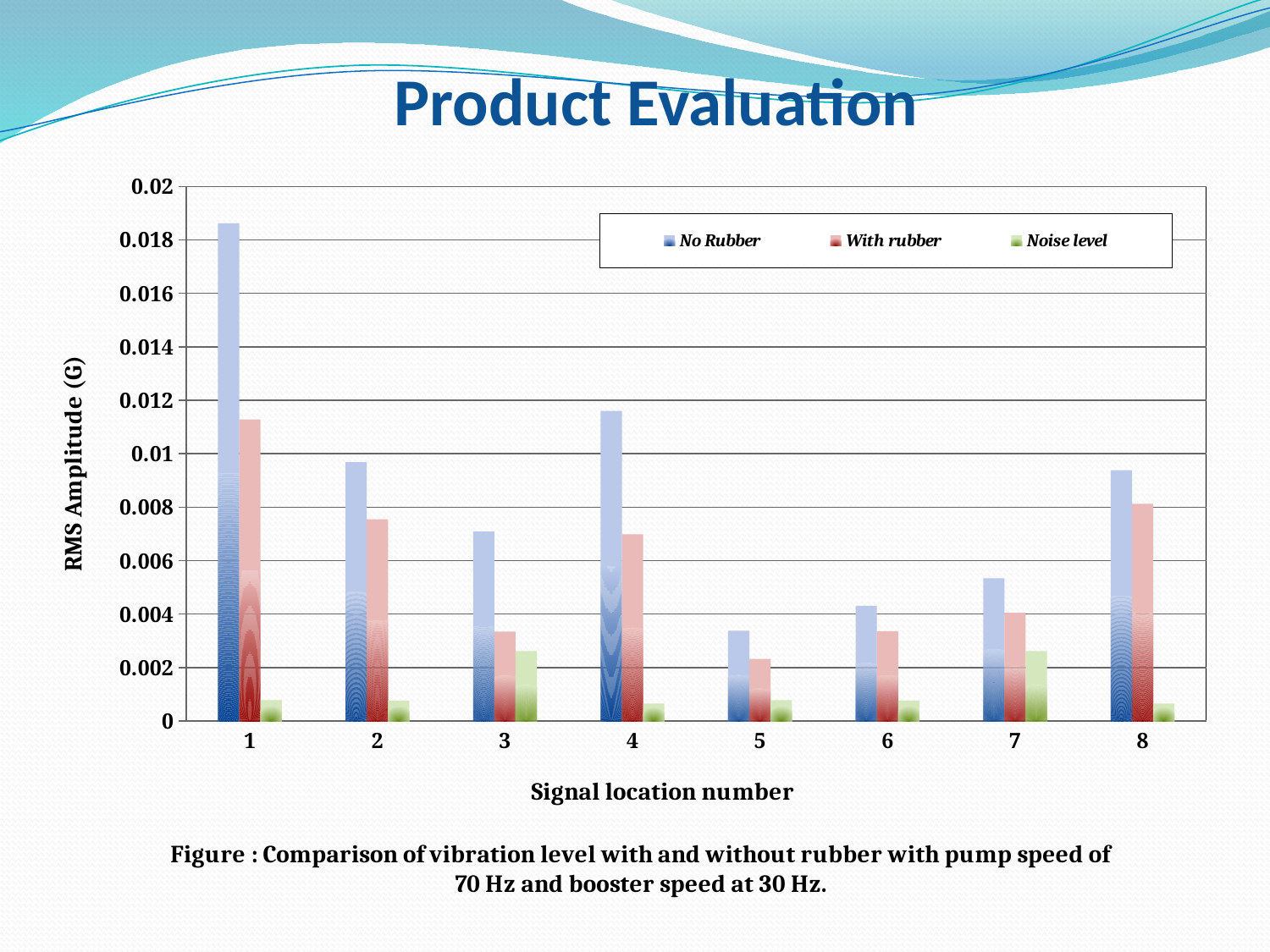
Which signal location has the lowest No Rubber value? 5 What is the title of the y axis? RMS Amplitude (G) How many series does the legend list? 3 Is the No Rubber value for signal location 1 greater or less than 0.016? greater Which signal location has the highest With rubber value? 1 Is the No Rubber value for signal location 5 greater or less than 0.004? less Is the With rubber value for signal location 1 greater or less than 0.01? greater How many signal location numbers are shown on the x axis? 8 Which is larger, the No Rubber value for signal location 4 or for signal location 2? signal location 4 Which signal location has the lowest With rubber value? 5 What kind of chart is shown on the slide? bar chart Which signal location has the highest No Rubber value? 1